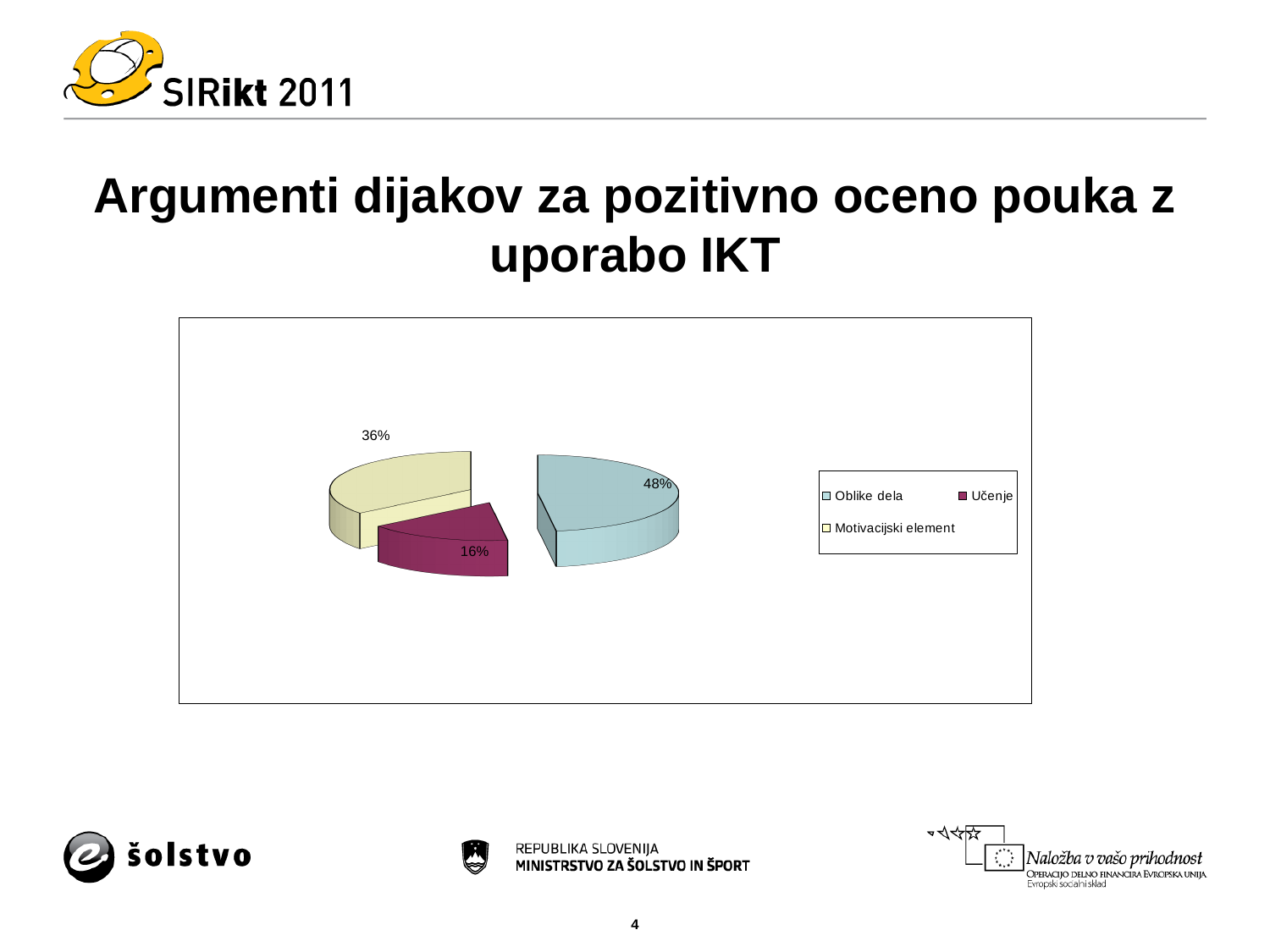
What is the difference in percentage points between Oblike dela and Motivacijski element? 12 What kind of chart is shown on the slide? pie chart Which legend entry is shown in the magenta colour? Učenje What is the difference in percentage points between Oblike dela and Učenje? 32 How many entries does the legend list? 3 How many slices does the pie chart have? 3 What share of the pie does Oblike dela have? 48% What share of the pie does Učenje have? 16% What share of the pie does Motivacijski element have? 36% Which is larger, the slice for Motivacijski element or the slice for Učenje? Motivacijski element Which category has the smallest slice of the pie? Učenje Which category has the largest slice of the pie? Oblike dela